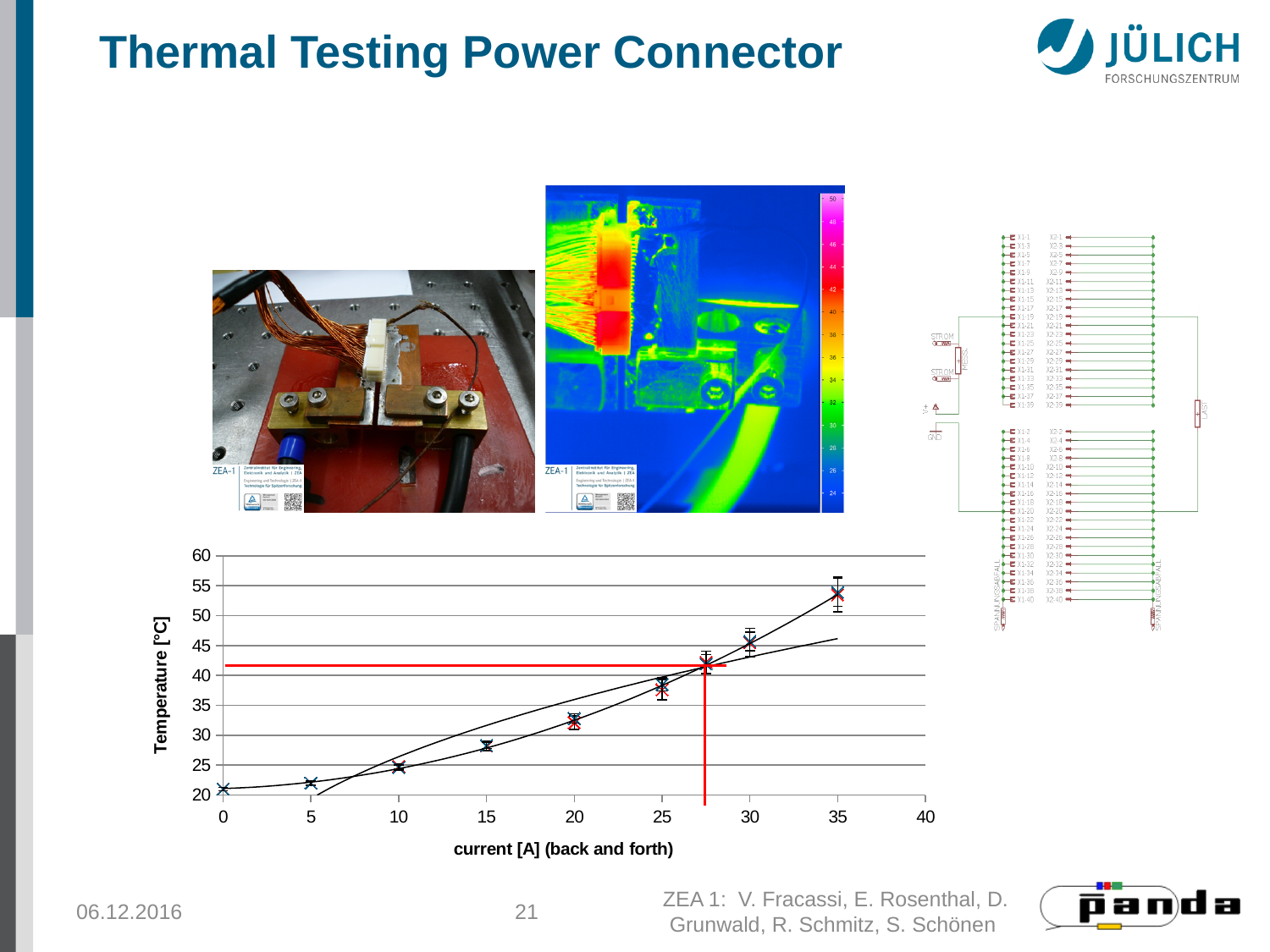
What kind of chart is shown at the bottom of the slide? scatter chart Is the temperature at 20 A greater or less than 30? greater Is the temperature at 0 A greater or less than 25? less At which current value is the measured temperature lowest? 0 At which current value is the measured temperature highest? 35 Does the temperature rise or fall as the current increases along the x axis? rise What is the label of the x axis of the chart? current [A] (back and forth) Is the temperature at 35 A greater or less than 50? greater Which is larger, the temperature at 15 A or the temperature at 30 A? 30 A What is the label of the y axis of the chart? Temperature [°C]